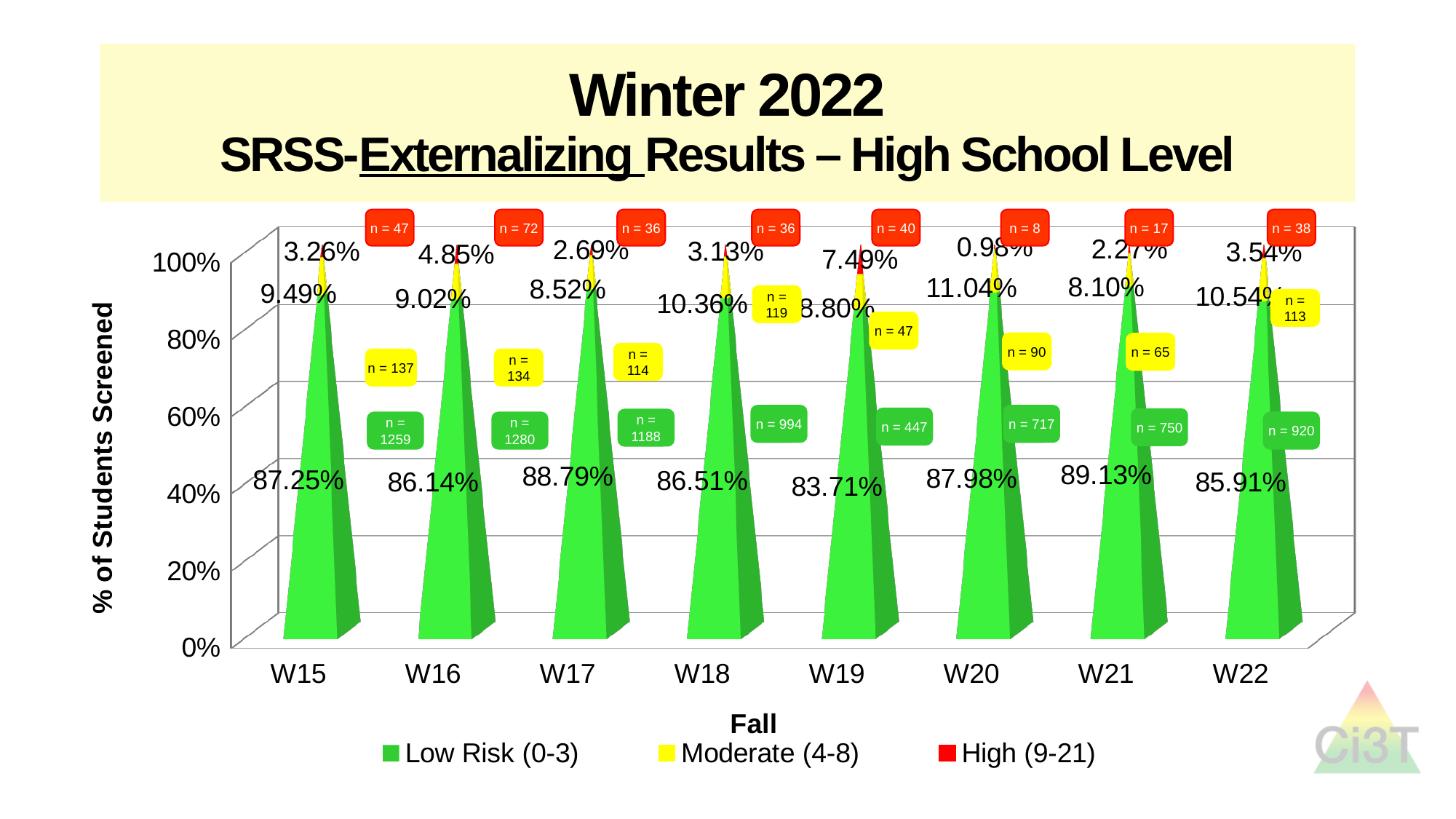
What is the difference between the Low Risk (0-3) percentages for W21 and W19? 5.42% How many students (n) were in the Low Risk (0-3) category at W16? n = 1280 What is the label on the y axis? % of Students Screened What percentage of students screened at W20 were in the Moderate (4-8) category? 11.04% How many series does the legend list? 3 What percentage of students screened at W17 were in the Low Risk (0-3) category? 88.79% Which school has the lowest High (9-21) percentage? W20 Which is larger, the Moderate (4-8) percentage for W18 or for W22? W22 How many schools are shown on the x axis? 8 Which school has the highest High (9-21) percentage? W19 Which school has the highest Low Risk (0-3) percentage? W21 What percentage of students screened at W19 were in the High (9-21) category? 7.49%